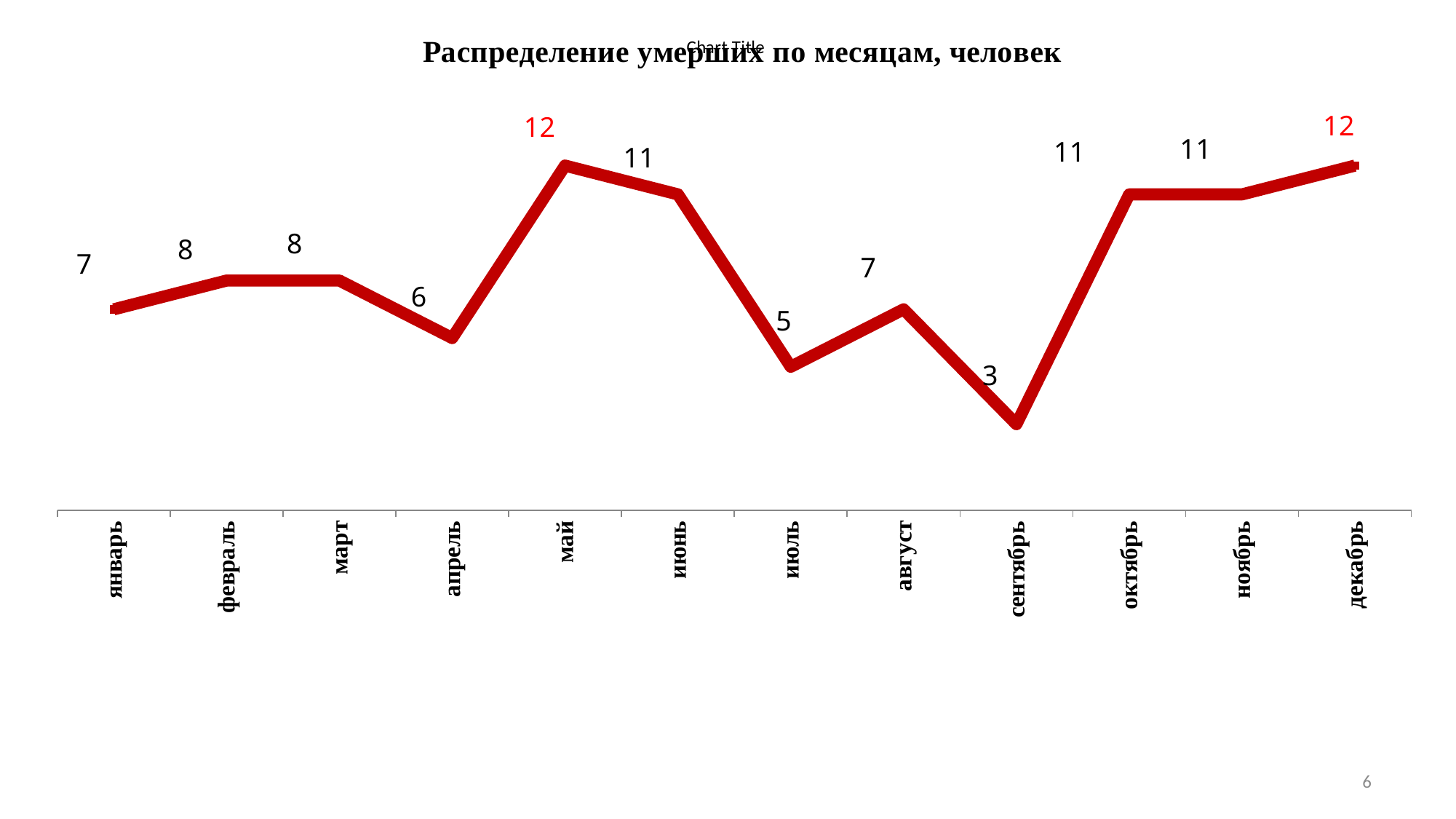
Which month has the lowest value? сентябрь What is the highest value shown on the chart? 12 What is the difference between the values for октябрь and июль? 6 What is the value for май (May)? 12 Do the values rise or fall from сентябрь to декабрь? rise What is the value for июнь (June)? 11 What is the value for сентябрь (September)? 3 Which is larger, the value for апрель or the value for август? август What is the value for январь (January)? 7 What kind of chart is shown on the slide? line chart How many months are plotted on the chart? 12 What is the difference between the values for май and сентябрь? 9